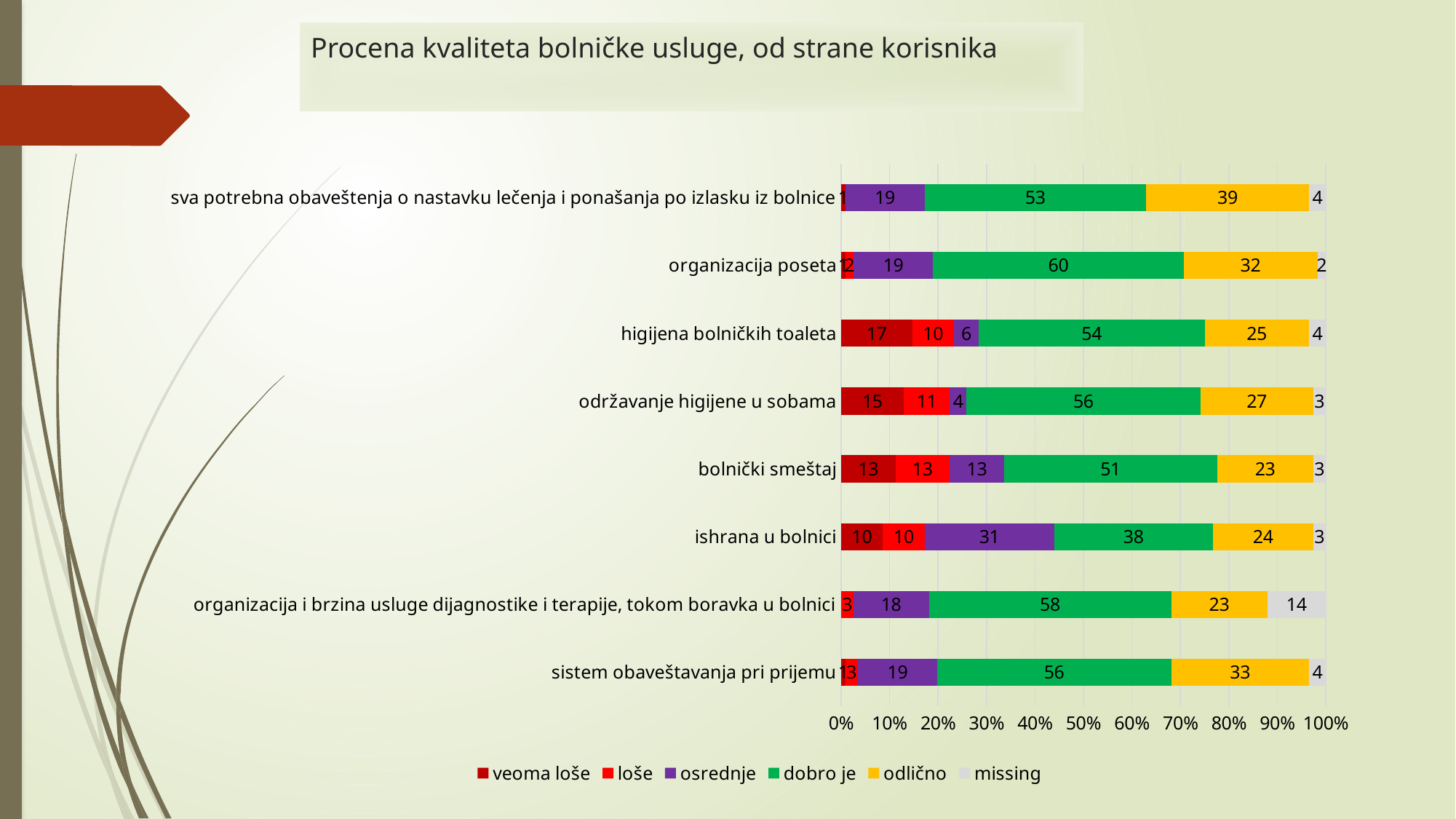
Which category has the lowest 'dobro je' value? ishrana u bolnici What is the 'missing' value for 'organizacija i brzina usluge dijagnostike i terapije, tokom boravka u bolnici'? 14 What is the difference between the 'dobro je' values for 'organizacija poseta' and 'ishrana u bolnici'? 22 Which category has the highest 'missing' value? organizacija i brzina usluge dijagnostike i terapije, tokom boravka u bolnici What is the 'veoma loše' value for 'higijena bolničkih toaleta'? 17 Which is larger: the 'odlično' value for 'sistem obaveštavanja pri prijemu' or for 'bolnički smeštaj'? sistem obaveštavanja pri prijemu Which category has the highest 'dobro je' value? organizacija poseta How many series does the legend list? 6 What is the 'osrednje' value for 'ishrana u bolnici'? 31 How many categories are shown on the chart? 8 What is the 'dobro je' value for 'organizacija poseta'? 60 What is the 'odlično' value for 'sva potrebna obaveštenja o nastavku lečenja i ponašanja po izlasku iz bolnice'? 39